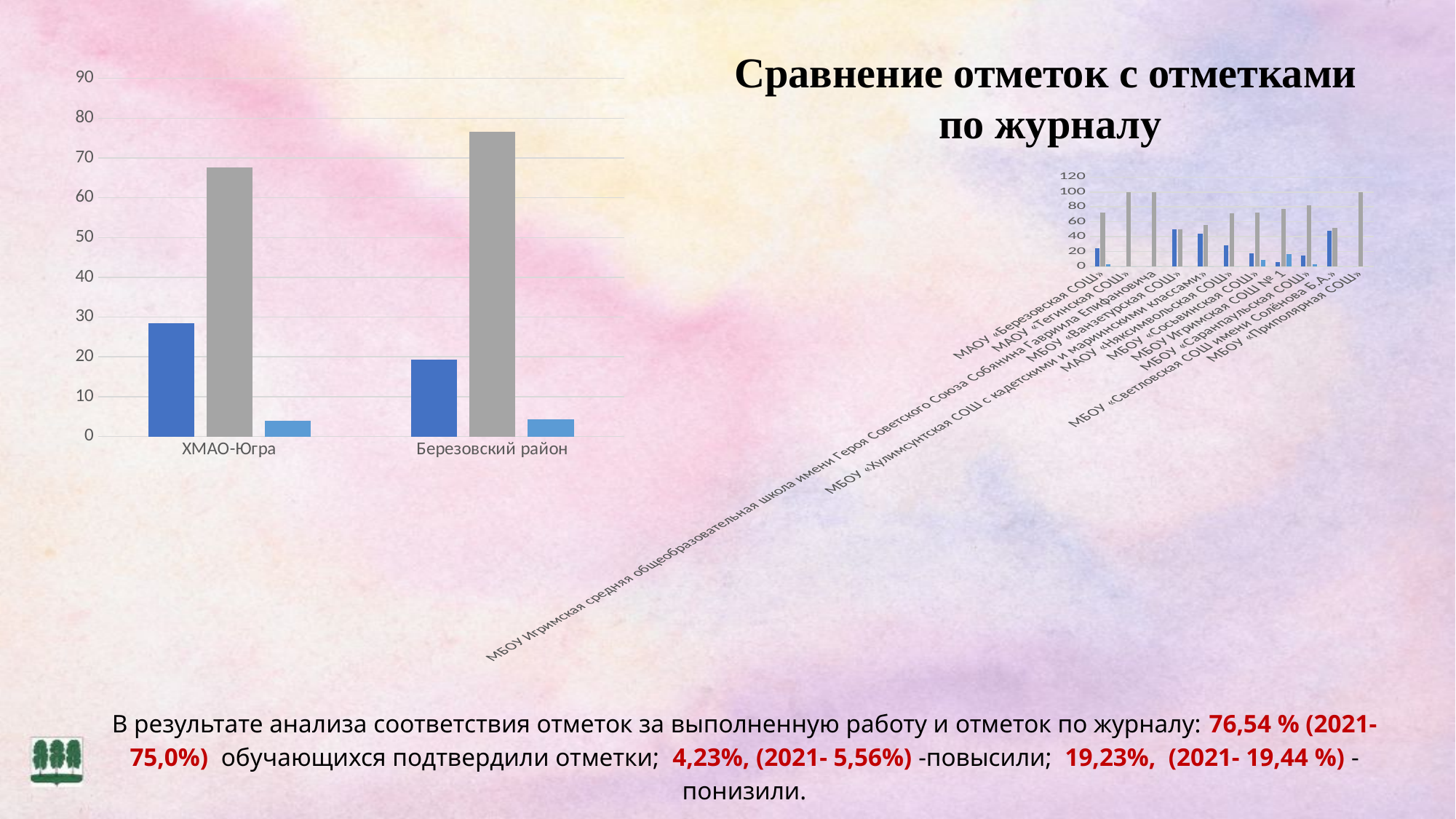
In the left chart, is the value of the dark blue bar for ХМАО-Югра greater or less than 30? less In the left chart, is the value of the gray bar for ХМАО-Югра greater or less than 60? greater How many categories are shown on the x axis of the left chart? 2 In the left chart, which category has the taller gray bar, ХМАО-Югра or Березовский район? Березовский район What kind of chart is the small chart on the right of the slide? bar chart In the left chart, which category has the taller dark blue bar, ХМАО-Югра or Березовский район? ХМАО-Югра What is the highest value shown on the vertical axis of the left chart? 90 In the left chart, is the value of the light blue bar for ХМАО-Югра greater or less than 10? less In the left chart, which bar is the tallest for Березовский район: the dark blue, gray or light blue one? gray What kind of chart is the chart on the left of the slide? bar chart